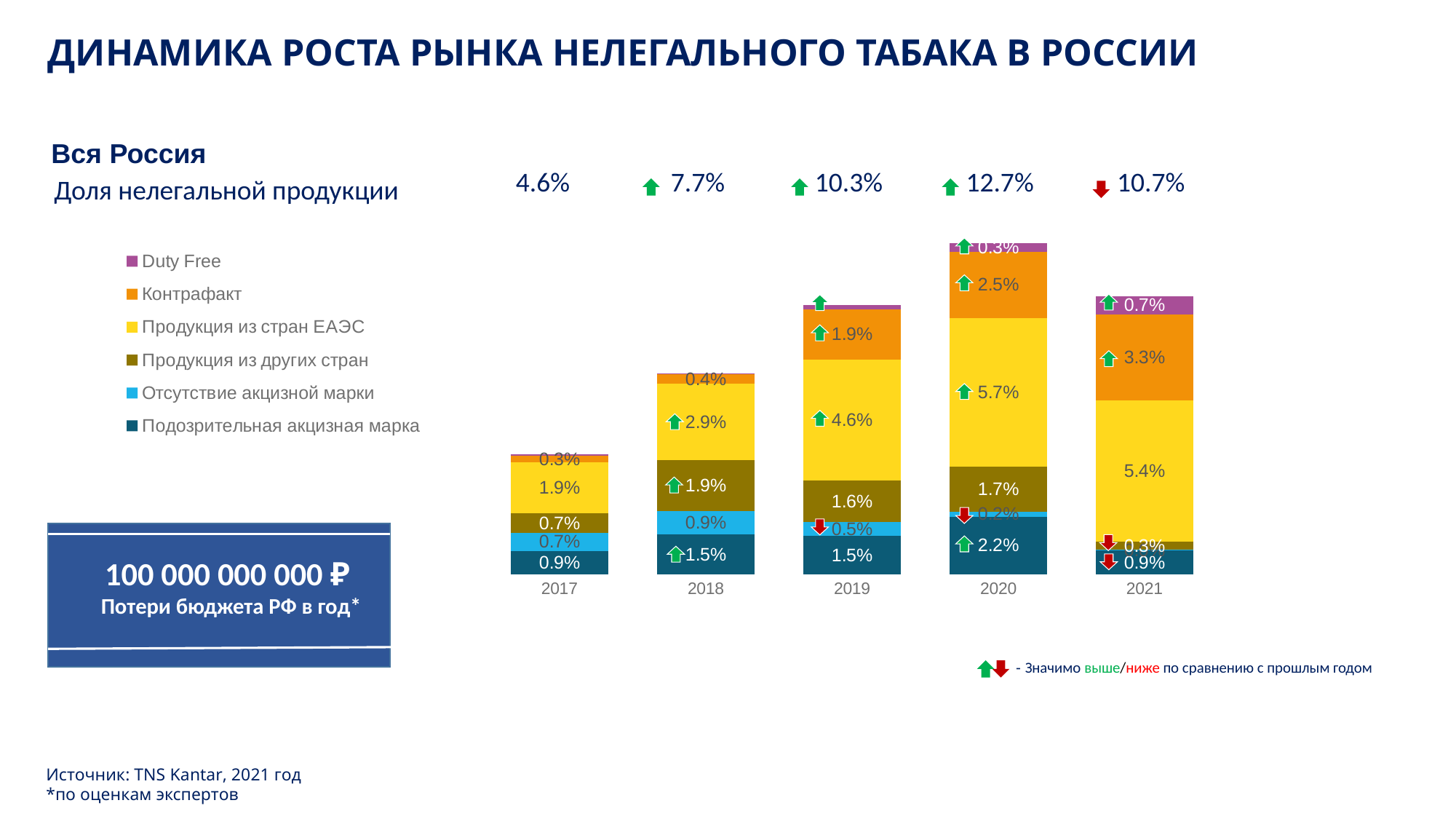
Which is larger: the Контрафакт value in 2021 or in 2020? 2021 What is the difference between the total share in 2020 and the total share in 2019? 2.4% How many years (categories) are shown on the x axis of the chart? 5 Which year has the lowest total share of illegal products? 2017 How many series does the chart legend list? 6 What is the value for Отсутствие акцизной марки in 2018? 0.9% What is the total share of illegal products for the 2020 bar? 12.7% What is the value for Подозрительная акцизная марка in 2019? 1.5% What kind of chart is shown on the slide? Stacked bar chart Which year has the highest total share of illegal products? 2020 What is the value for Контрафакт in 2020? 2.5% What is the value for Продукция из стран ЕАЭС in 2021? 5.4%